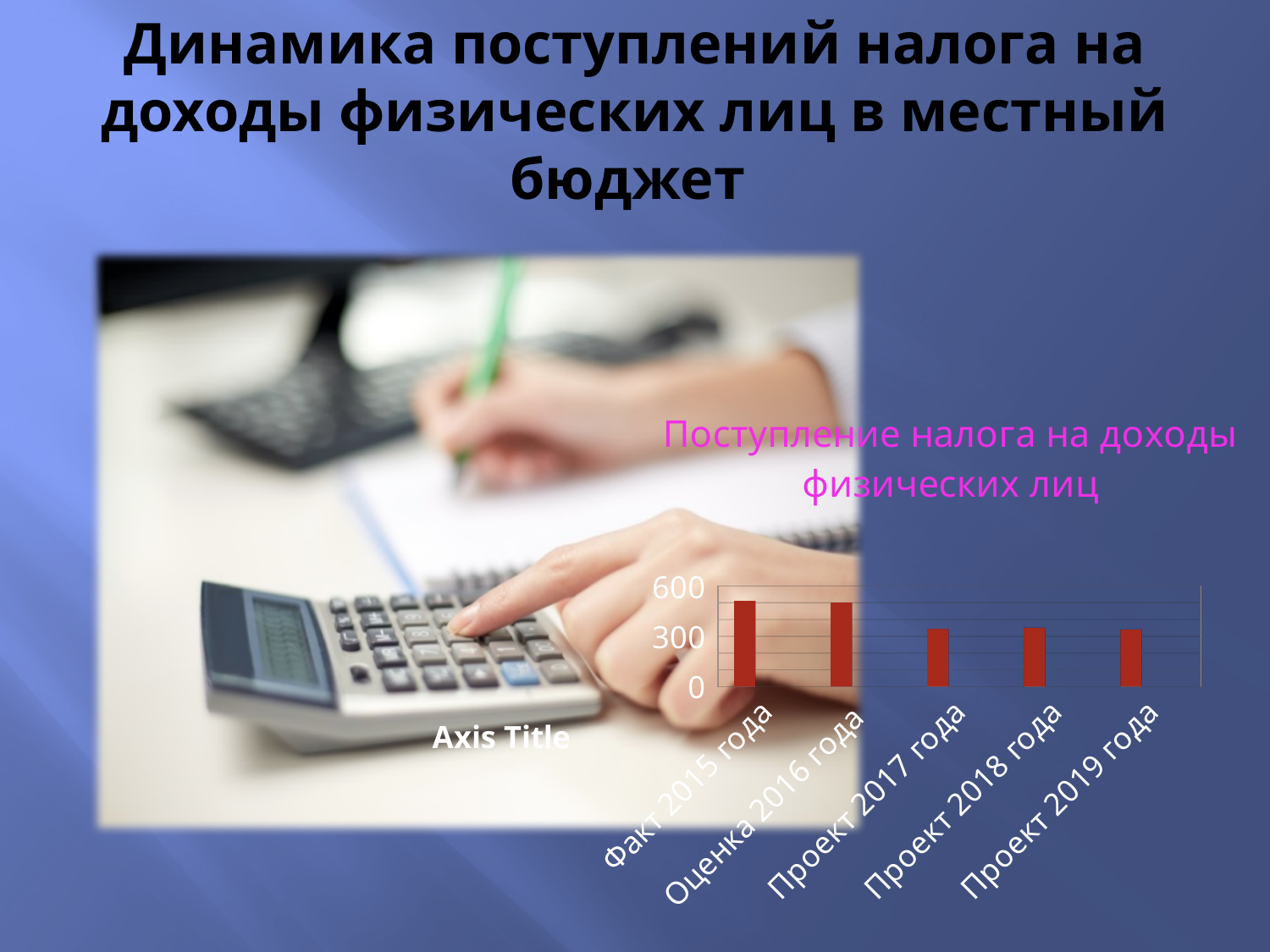
Is the value for Факт 2015 года greater or less than 600? less Is the value for Проект 2019 года greater or less than 600? less Is the value for Оценка 2016 года greater or less than 300? greater Do the values generally rise or fall from Факт 2015 года to Проект 2019 года? fall What kind of chart is shown on the slide? bar chart What is the label shown for the horizontal axis title? Axis Title How many categories are shown on the x axis of the chart? 5 Which is larger, the value for Факт 2015 года or the value for Проект 2017 года? Факт 2015 года What is the title of the chart? Поступление налога на доходы физических лиц Which is larger, the value for Оценка 2016 года or the value for Проект 2019 года? Оценка 2016 года